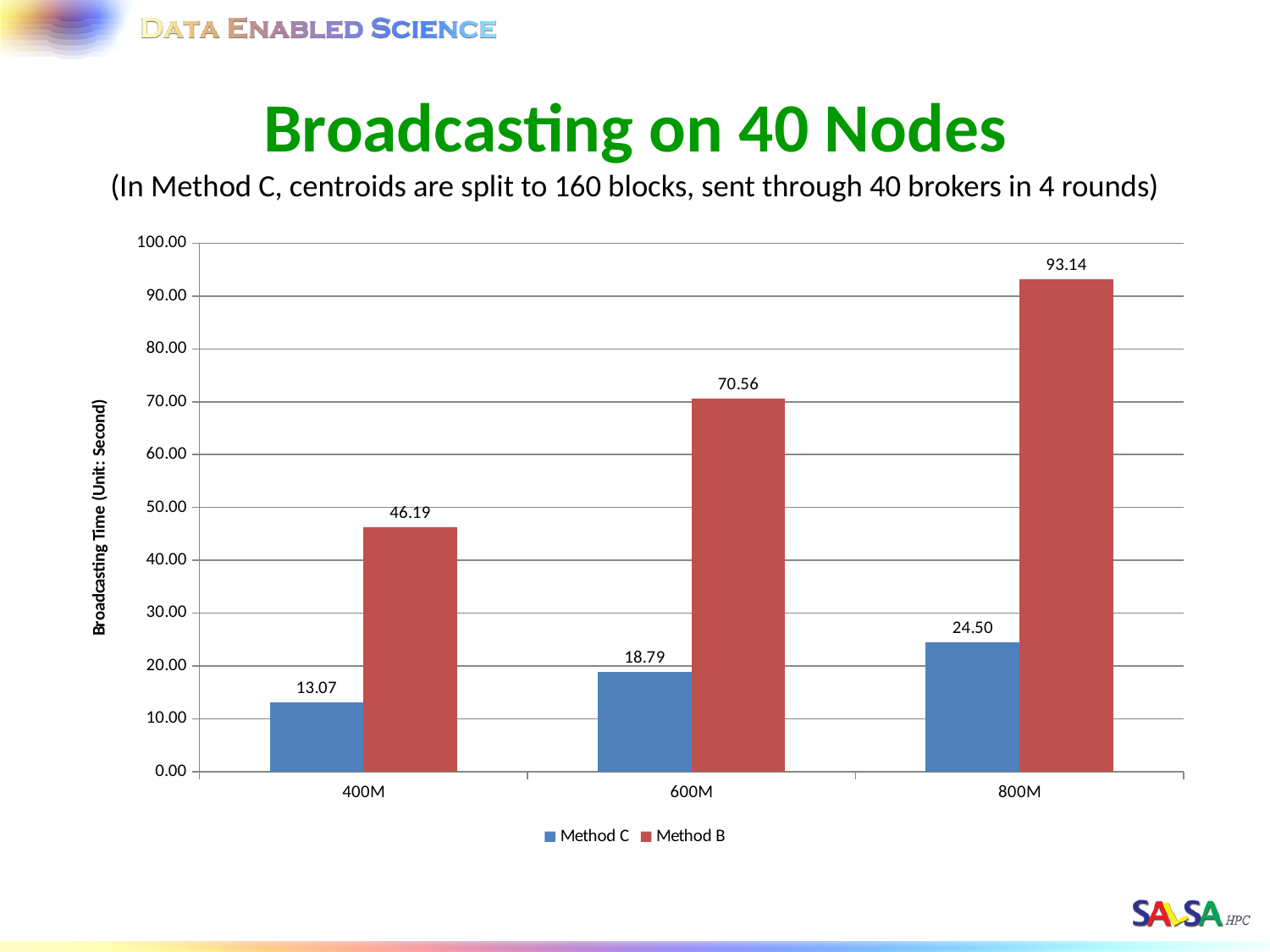
What is the difference between Method B and Method C broadcasting times at 600M? 51.77 What is the broadcasting time for Method B at 400M? 46.19 Does the broadcasting time for Method B rise or fall as the data size increases from 400M to 800M? Rise At which data size does Method C have the lowest broadcasting time? 400M What is the broadcasting time for Method C at 400M? 13.07 Which method has the larger broadcasting time at 800M, Method C or Method B? Method B How many data size categories are shown on the x axis? 3 What kind of chart is shown on the slide? Bar chart At which data size does Method B have the highest broadcasting time? 800M What is the broadcasting time for Method B at 800M? 93.14 What is the broadcasting time for Method C at 600M? 18.79 How many series does the legend list? 2